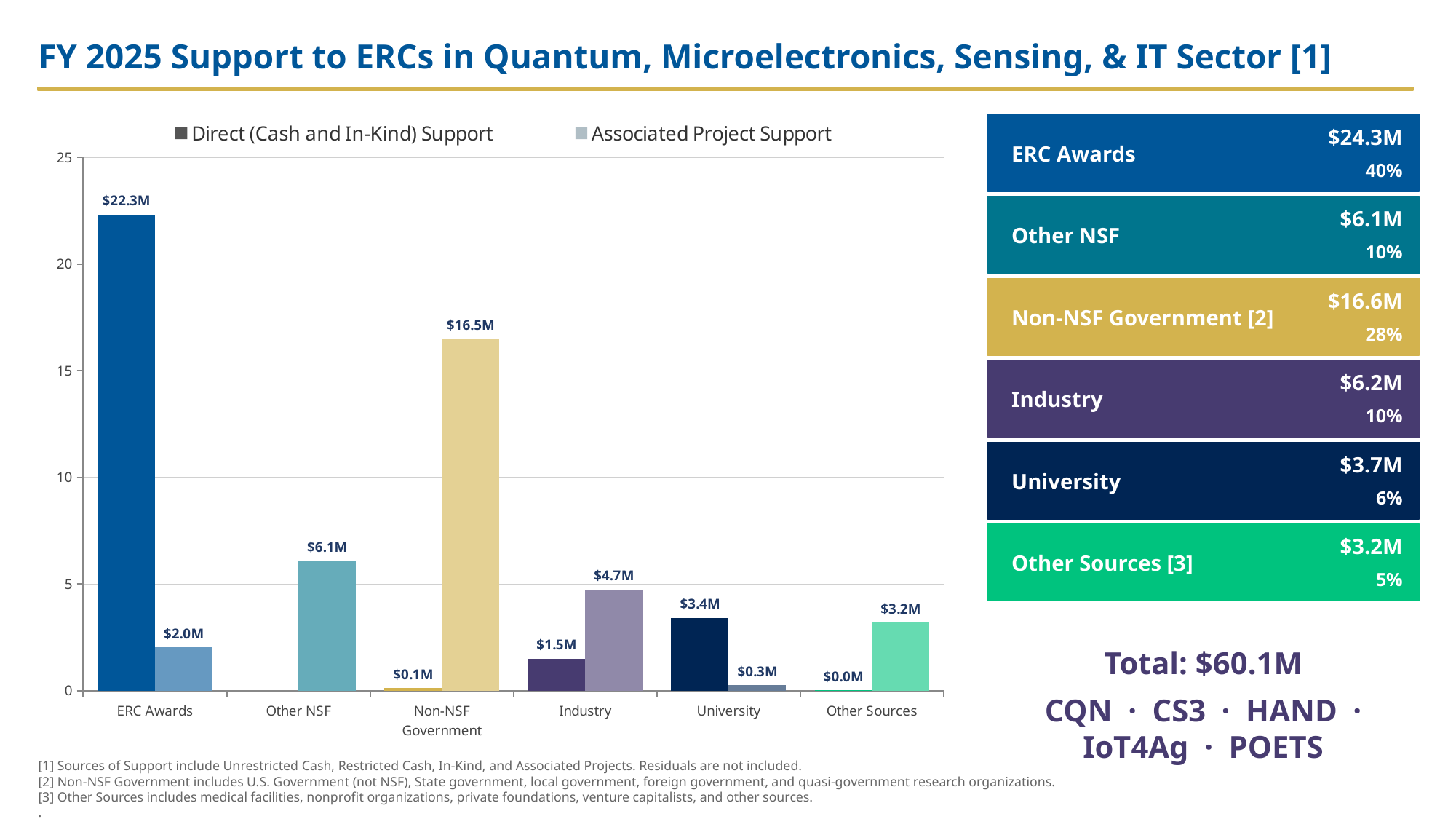
How many series does the chart legend list? 2 Which category has the highest Direct (Cash and In-Kind) Support? ERC Awards How many categories are shown on the x axis of the chart? 6 Which is larger for Industry: Direct (Cash and In-Kind) Support or Associated Project Support? Associated Project Support Which category has the highest Associated Project Support? Non-NSF Government What is the Associated Project Support value for Industry? $4.7M Which category has the lowest Associated Project Support? University What is the Direct (Cash and In-Kind) Support value for ERC Awards? $22.3M What is the difference between the Direct (Cash and In-Kind) Support and the Associated Project Support for ERC Awards? $20.3M What kind of chart is shown on the slide? Bar chart What is the Associated Project Support value for Non-NSF Government? $16.5M What is the Direct (Cash and In-Kind) Support value for University? $3.4M